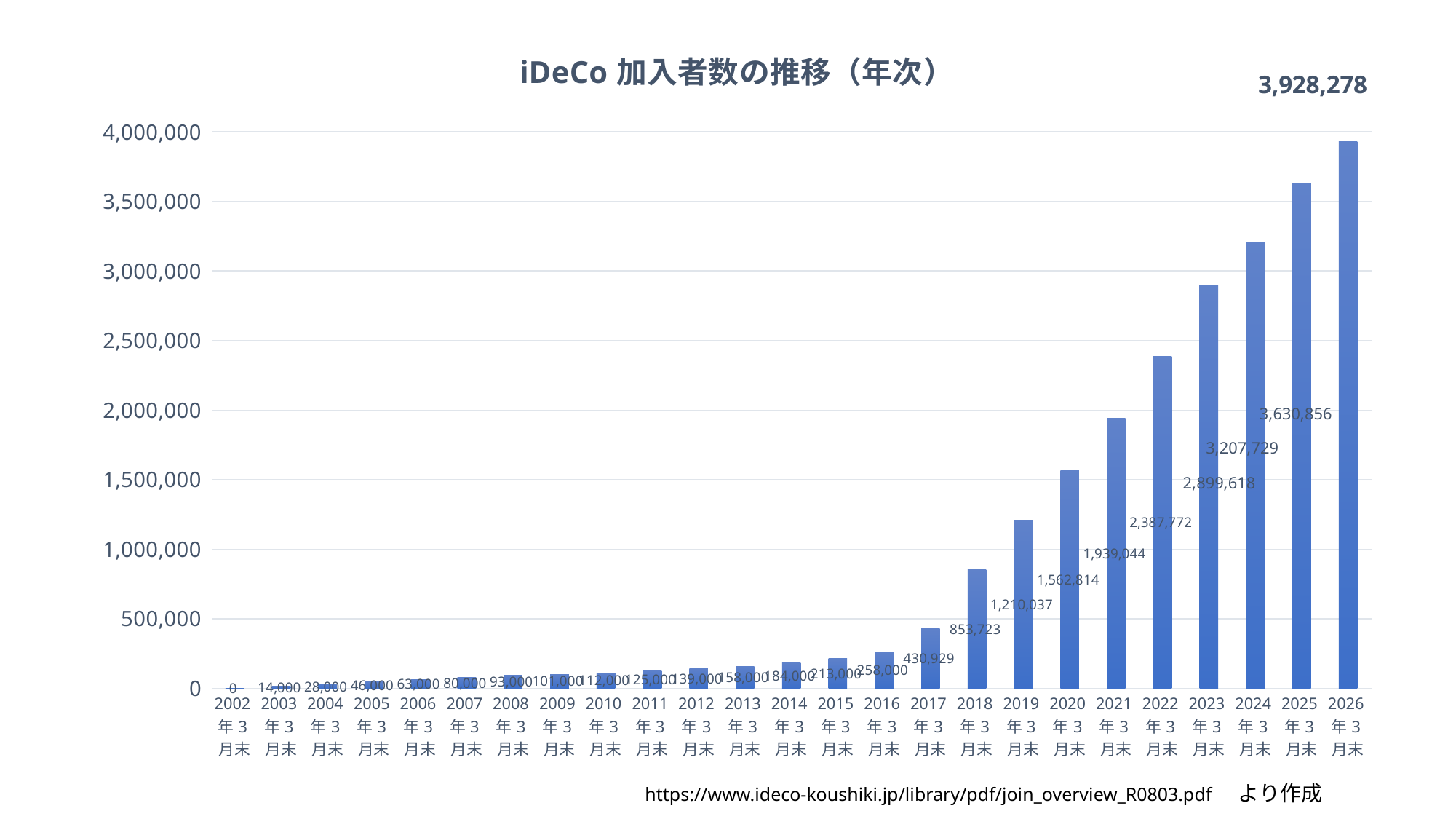
Do the values rise or fall from 2002 to 2026 along the x axis? rise Which year has the highest value? 2026年3月末 What is the difference between the values for 2026年3月末 and 2025年3月末? 297,422 What is the value for 2024年3月末? 3,207,729 What kind of chart is shown on the slide? bar chart Which year has the lowest value? 2002年3月末 What is the value for 2017年3月末? 430,929 How many bars (years) are plotted in the chart? 25 What is the value for 2021年3月末? 1,939,044 What is the value for 2026年3月末? 3,928,278 Which is larger, the value for 2019年3月末 or the value for 2020年3月末? 2020年3月末 What is the title of the chart? iDeCo 加入者数の推移（年次）